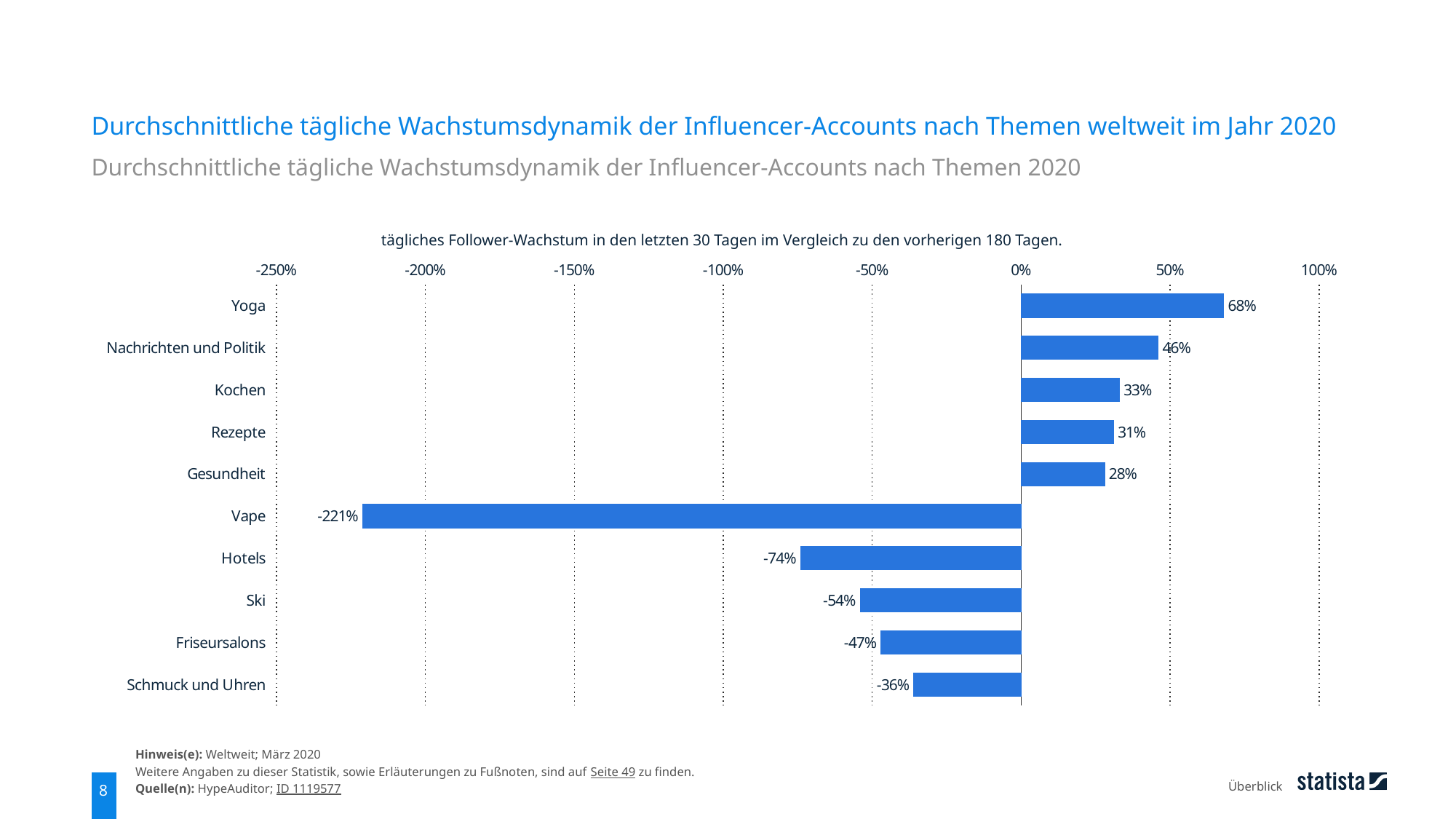
What is the value for Vape? -221% What is the title of the chart? Durchschnittliche tägliche Wachstumsdynamik der Influencer-Accounts nach Themen weltweit im Jahr 2020 Which category has the highest value? Yoga What is the value for Yoga? 68% What kind of chart is shown on the slide? Bar chart Is the value for Ski greater or less than -50%? less How many categories are shown in the chart? 10 What is the value for Hotels? -74% Which has a larger value, Kochen or Rezepte? Kochen Which category has the lowest value? Vape What is the difference between the values for Yoga and Nachrichten und Politik? 22 percentage points What is the value for Gesundheit? 28%